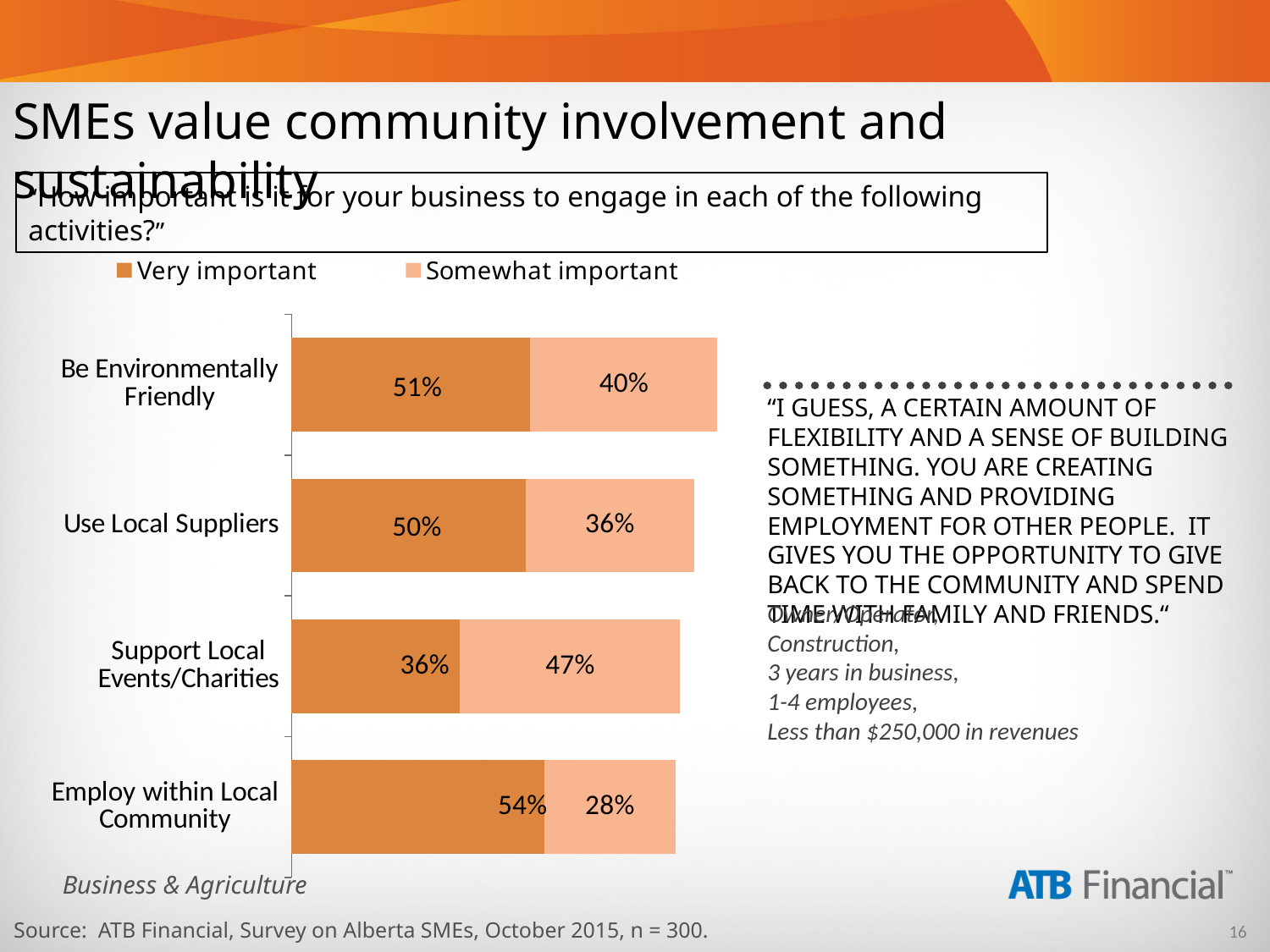
What is the combined total of 'Very important' and 'Somewhat important' for Use Local Suppliers? 86% What is the difference between the 'Very important' and 'Somewhat important' values for Employ within Local Community? 26% What percentage of SMEs said it is very important to be environmentally friendly? 51% How many series does the legend list? 2 Which activity has the lowest 'Somewhat important' percentage? Employ within Local Community What type of chart is shown on the slide? Stacked bar chart Which is larger for Support Local Events/Charities: the 'Very important' or the 'Somewhat important' share? Somewhat important What is the 'Very important' value for Employ within Local Community? 54% What is the combined total of 'Very important' and 'Somewhat important' for Be Environmentally Friendly? 91% How many activities are shown in the chart? 4 Which activity has the highest 'Very important' percentage? Employ within Local Community What percentage of SMEs said it is somewhat important to support local events/charities? 47%